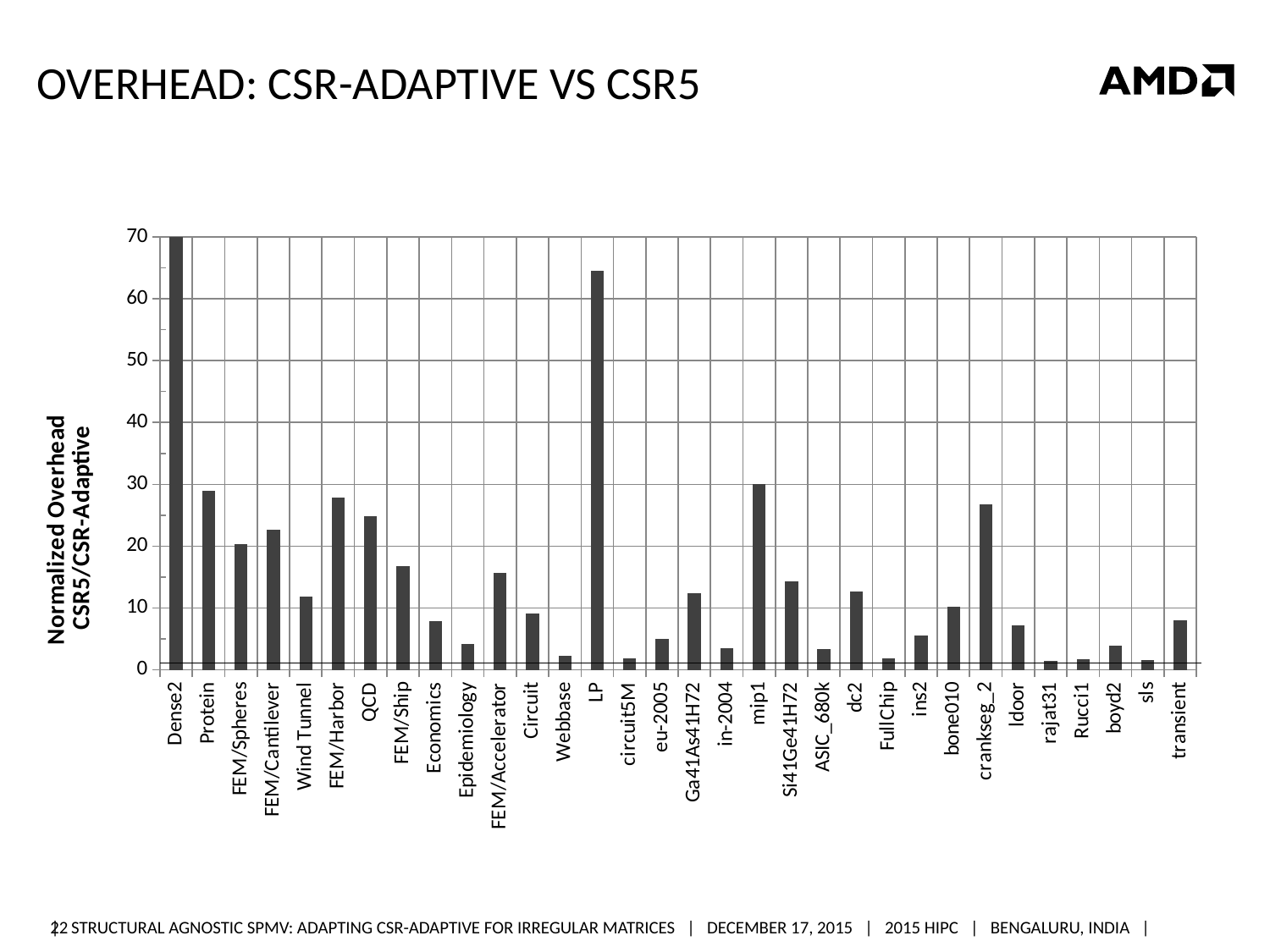
Is the value for LP greater or less than 60? greater Is the value for Economics greater or less than 10? less What is the label of the vertical axis? Normalized Overhead CSR5/CSR-Adaptive Which has the larger value, Protein or FEM/Spheres? Protein Is the value for Si41Ge41H72 greater or less than 10? greater Which category has the highest normalized overhead? Dense2 What kind of chart is shown on the slide? bar chart Which has the larger value, LP or mip1? LP How many categories (matrices) are plotted along the x axis? 32